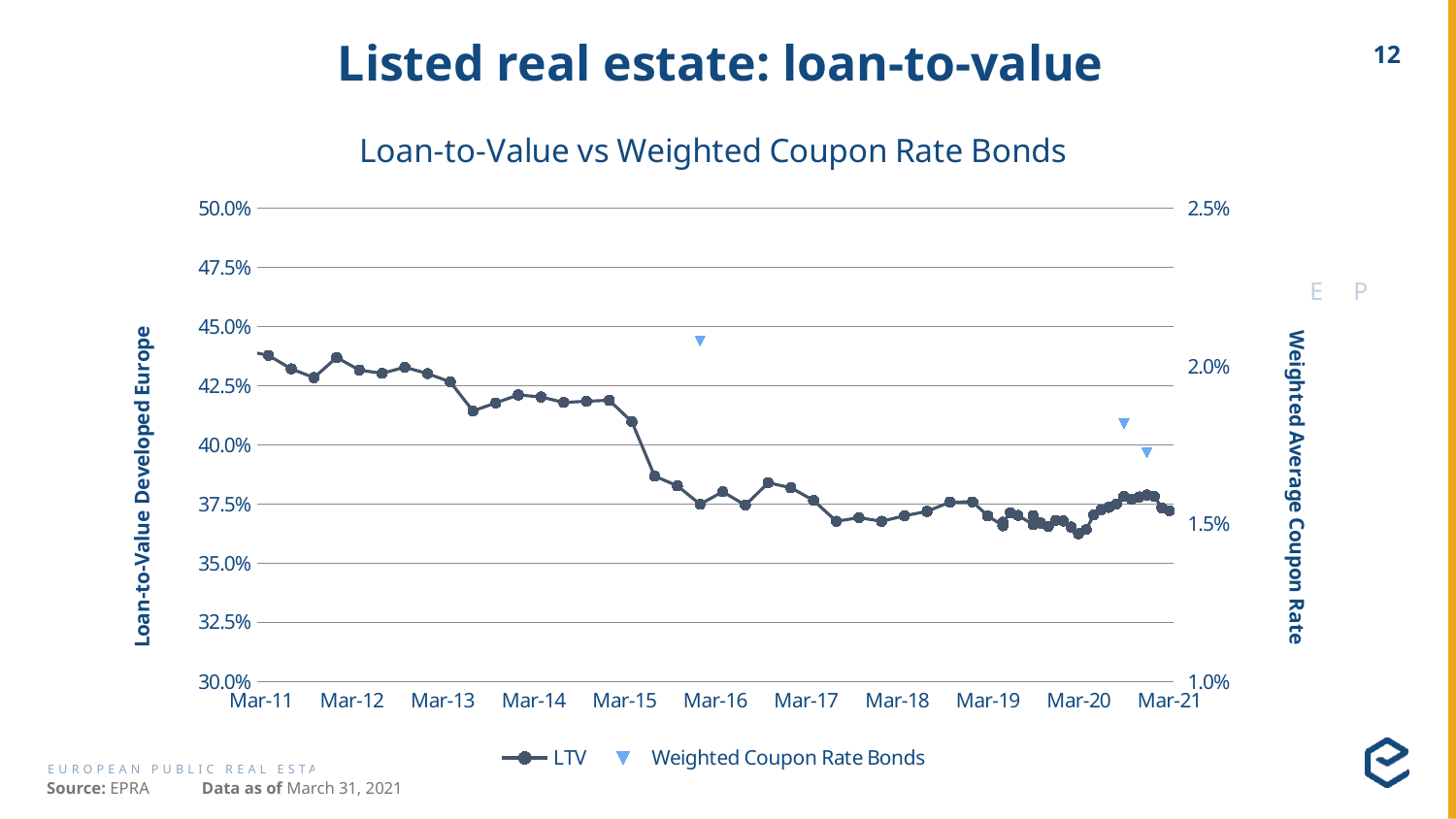
Which is larger, the LTV value at Mar-13 or at Mar-17? Mar-13 What kind of chart is shown on the slide? Line chart What is the title of the left vertical axis? Loan-to-Value Developed Europe Is the LTV value at Mar-11 greater or less than 42.5%? greater Is the LTV value at Mar-21 greater or less than 40.0%? less How many year labels are shown on the x axis? 11 Which is larger, the LTV value at Mar-11 or at Mar-21? Mar-11 Is the Weighted Coupon Rate Bonds value at Mar-16 greater or less than 2.0%? greater What is the title of the chart? Loan-to-Value vs Weighted Coupon Rate Bonds Does the LTV series generally rise or fall from Mar-11 to Mar-21? Fall How many series does the legend list? 2